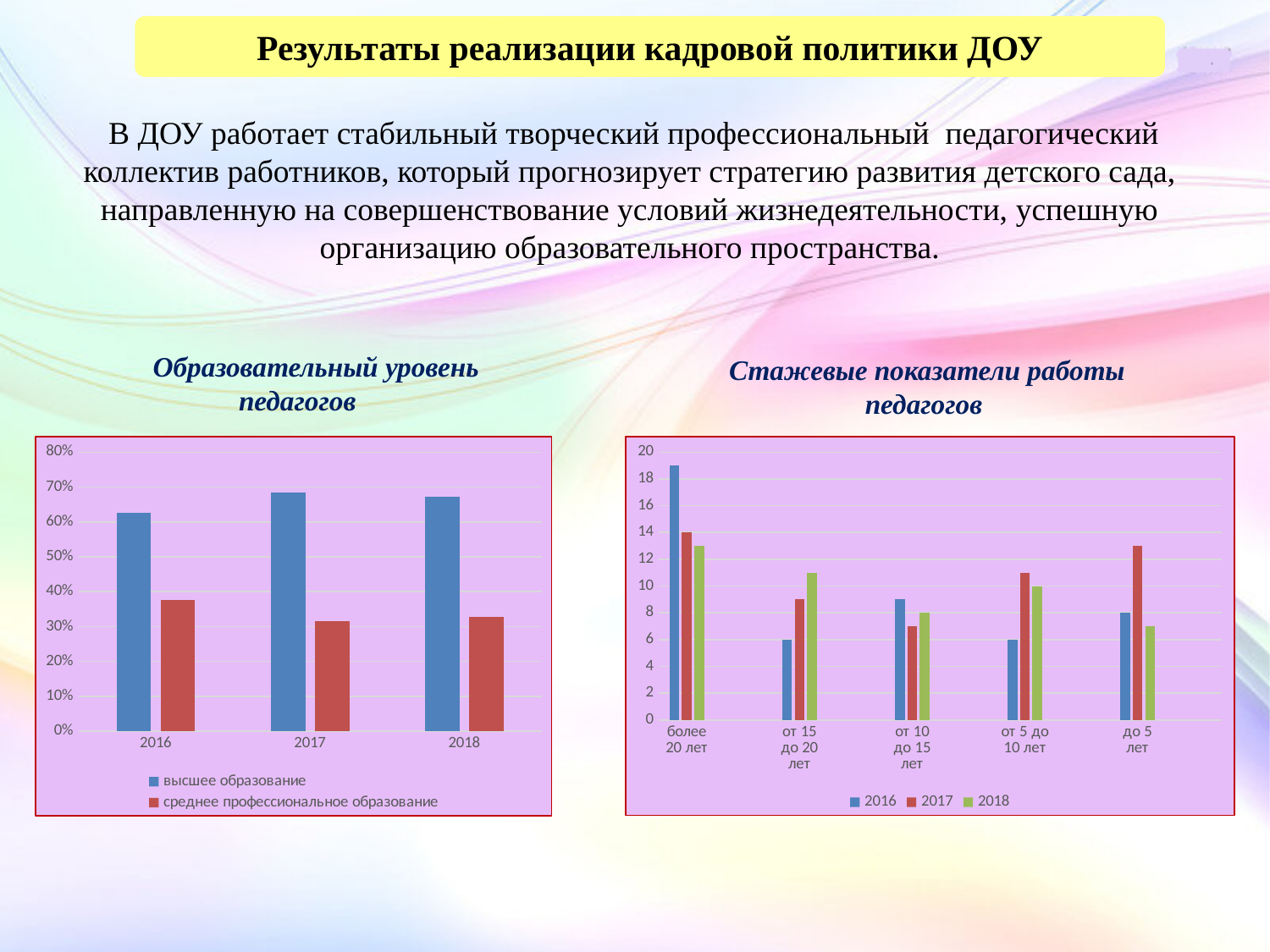
How many categories are shown on the x axis of the right chart, 'Стажевые показатели работы педагогов'? 5 In the right chart, 'Стажевые показатели работы педагогов', which is larger in the category 'до 5 лет': the 2017 value or the 2018 value? 2017 In the right chart, 'Стажевые показатели работы педагогов', which category has the highest value for the 2016 series? более 20 лет In the right chart, 'Стажевые показатели работы педагогов', what is the value for 2017 in the category 'более 20 лет'? 14 In the right chart, 'Стажевые показатели работы педагогов', what is the difference between the 2017 value for 'более 20 лет' and the 2016 value for 'от 15 до 20 лет'? 8 In the right chart, 'Стажевые показатели работы педагогов', is the value for 2016 in the category 'более 20 лет' greater or less than 18? greater In the right chart, 'Стажевые показатели работы педагогов', what is the value for 2018 in the category 'от 5 до 10 лет'? 10 How many series does the legend of the right chart, 'Стажевые показатели работы педагогов', list? 3 How many years are shown on the x axis of the left chart, 'Образовательный уровень педагогов'? 3 In the right chart, 'Стажевые показатели работы педагогов', what is the value for 2016 in the category 'до 5 лет'? 8 What kind of chart is the left chart, 'Образовательный уровень педагогов'? bar chart In the left chart, 'Образовательный уровень педагогов', is the value for 'высшее образование' in 2016 greater or less than 60%? greater